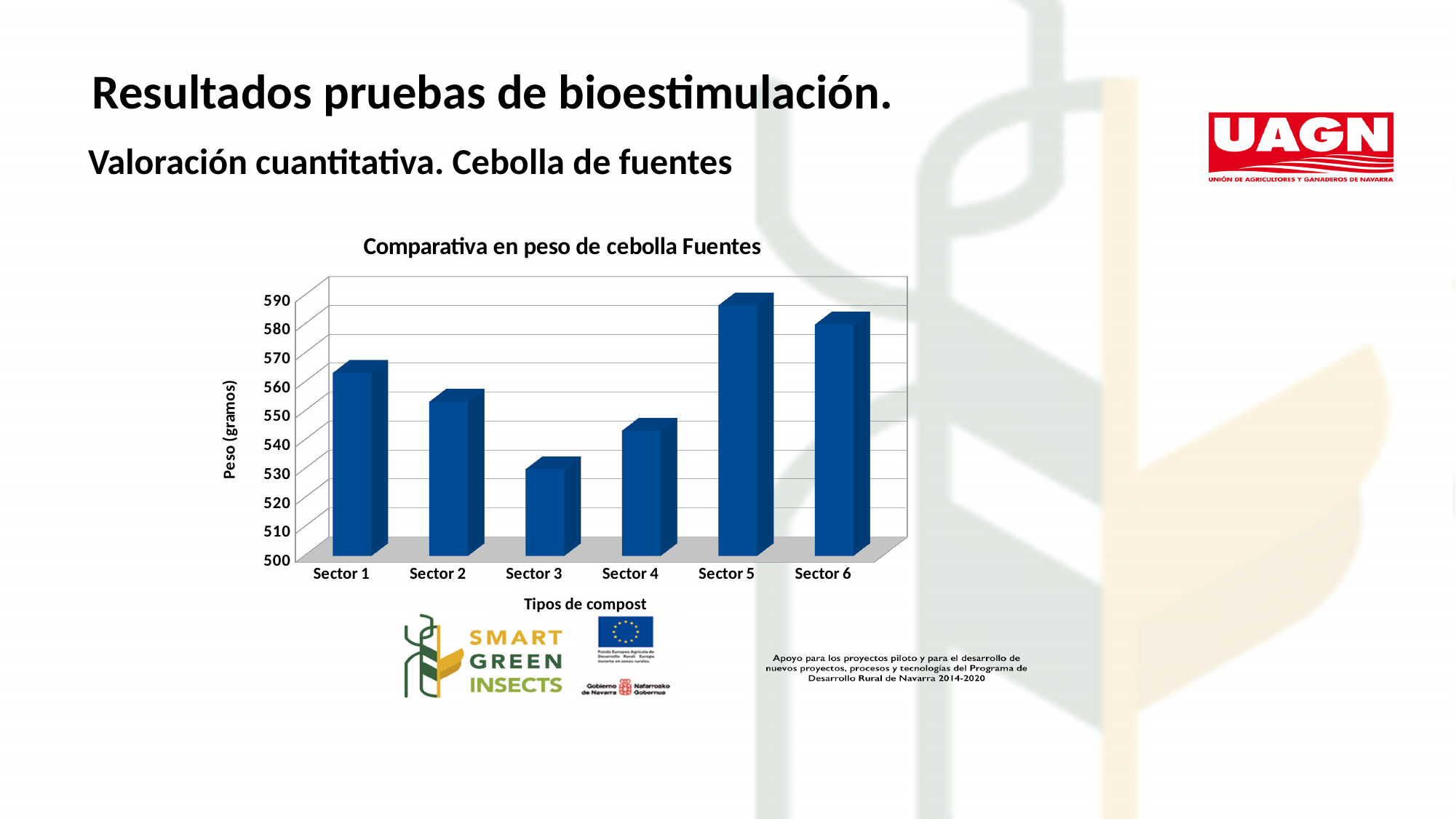
How many sectors are plotted on the x axis of the chart? 6 Is the value for Sector 1 greater or less than 550? greater What kind of chart is shown on the slide? bar chart Which sector has the highest weight in the chart? Sector 5 What is the label of the vertical axis of the chart? Peso (gramos) Which has a higher weight, Sector 1 or Sector 2? Sector 1 Is the value for Sector 5 greater or less than 580? greater Is the value for Sector 3 greater or less than 540? less What is the title of the chart? Comparativa en peso de cebolla Fuentes Which sector has the lowest weight in the chart? Sector 3